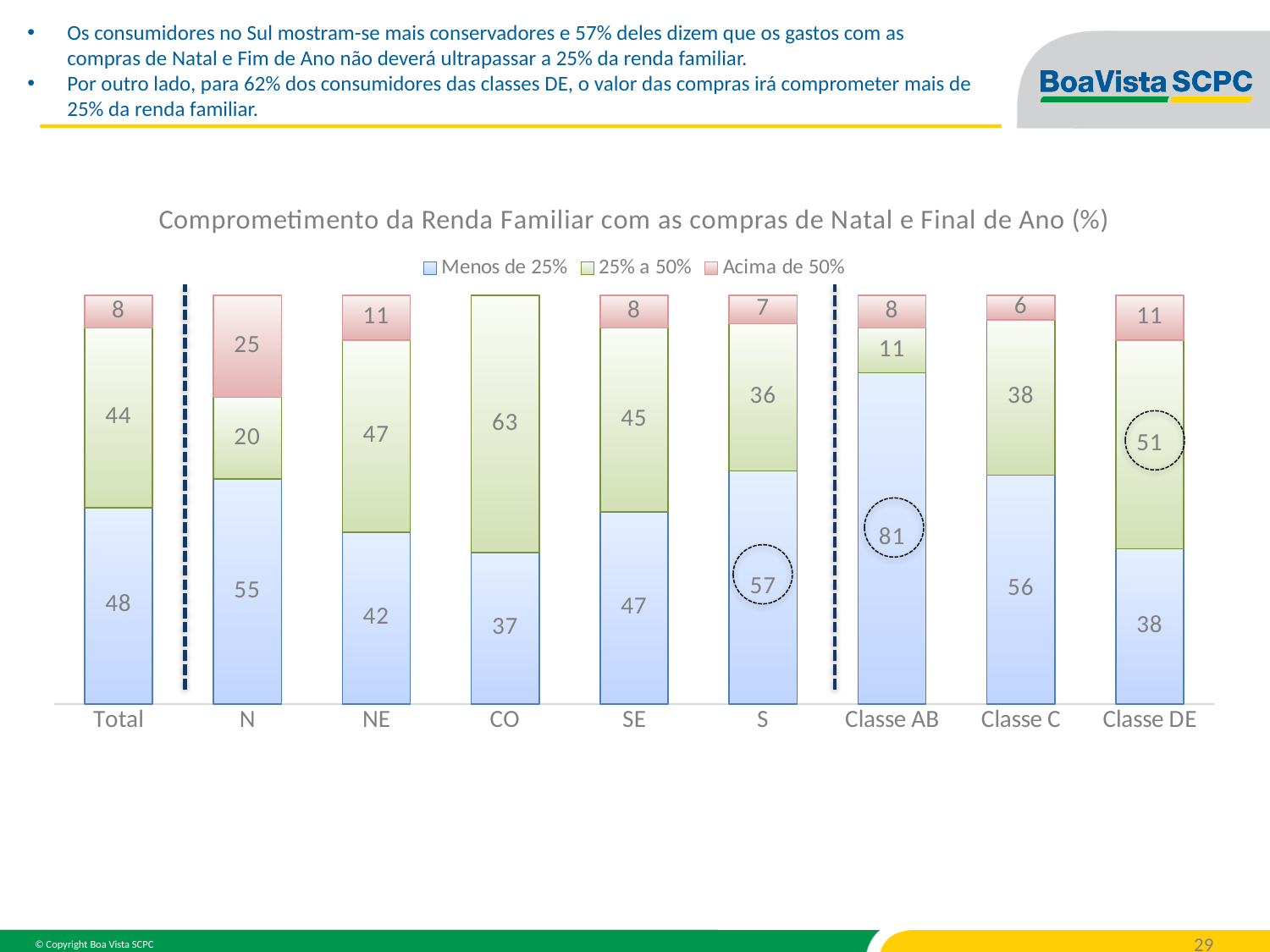
What kind of chart is shown on the slide? stacked bar chart What is the value of 'Menos de 25%' for Classe AB? 81 Which category has the lowest value for 'Menos de 25%'? CO What is the value of '25% a 50%' for CO? 63 Which category has the highest value for 'Menos de 25%'? Classe AB How many categories are shown along the x axis? 9 How many series does the legend list? 3 What is the title of the chart? Comprometimento da Renda Familiar com as compras de Natal e Final de Ano (%) What is the value of 'Acima de 50%' for N? 25 What is the total of the stacked bar for Classe C? 100 What is the difference between the 'Menos de 25%' values for S and Classe DE? 19 Which is larger: the 'Acima de 50%' value for NE or for SE? NE